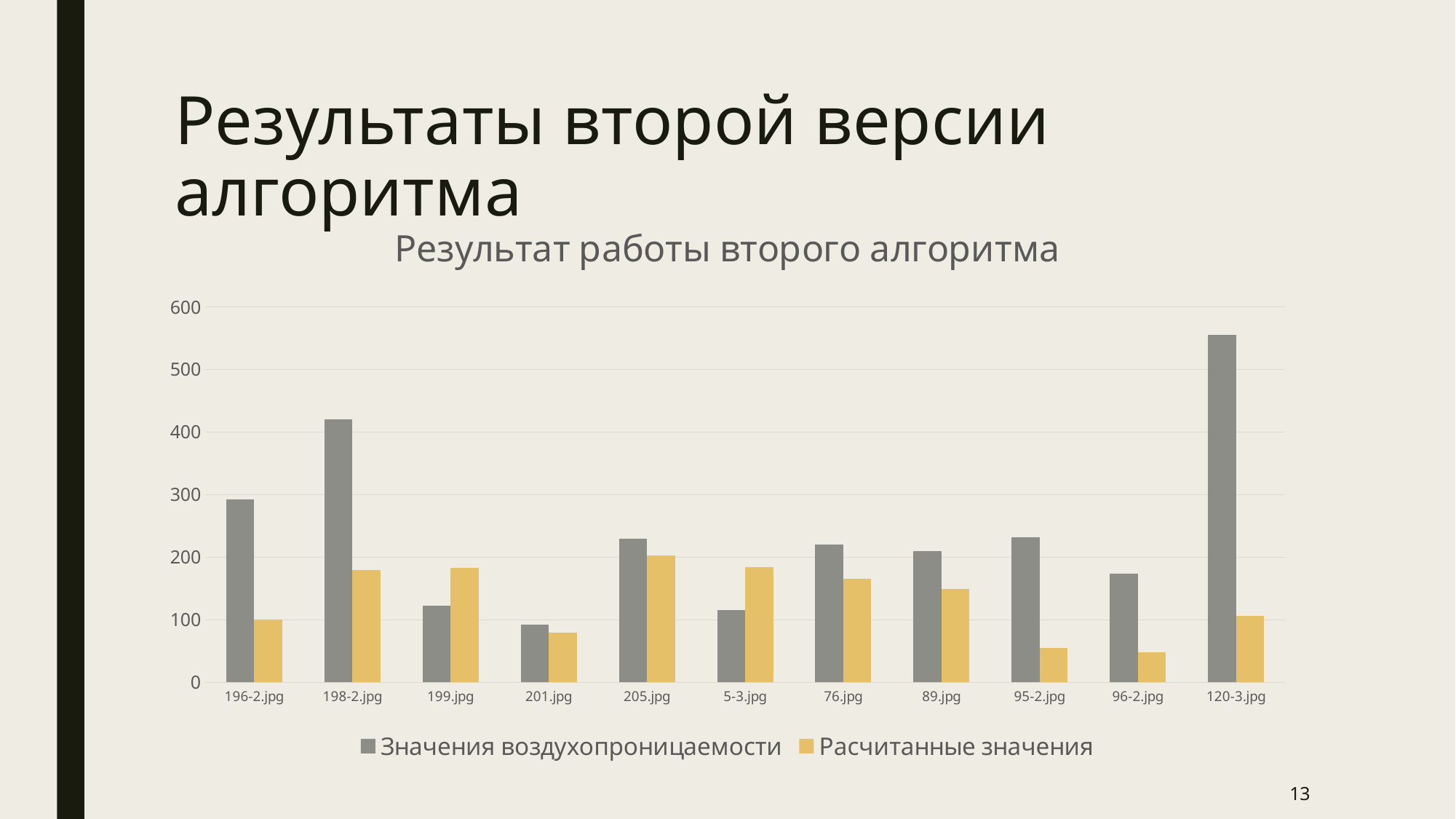
Which category has the highest value for Значения воздухопроницаемости? 120-3.jpg For 198-2.jpg, which is larger: Значения воздухопроницаемости or Расчитанные значения? Значения воздухопроницаемости How many series does the legend list? 2 For 199.jpg, which is larger: Значения воздухопроницаемости or Расчитанные значения? Расчитанные значения Which category has the highest value for Расчитанные значения? 205.jpg What is the title of the chart? Результат работы второго алгоритма Is the value for Значения воздухопроницаемости at 198-2.jpg greater or less than 400? greater How many categories are shown on the x axis? 11 Is the value for Значения воздухопроницаемости at 120-3.jpg greater or less than 500? greater Which category has the lowest value for Значения воздухопроницаемости? 201.jpg What kind of chart is shown on the slide? bar chart Is the value for Расчитанные значения at 96-2.jpg greater or less than 100? less